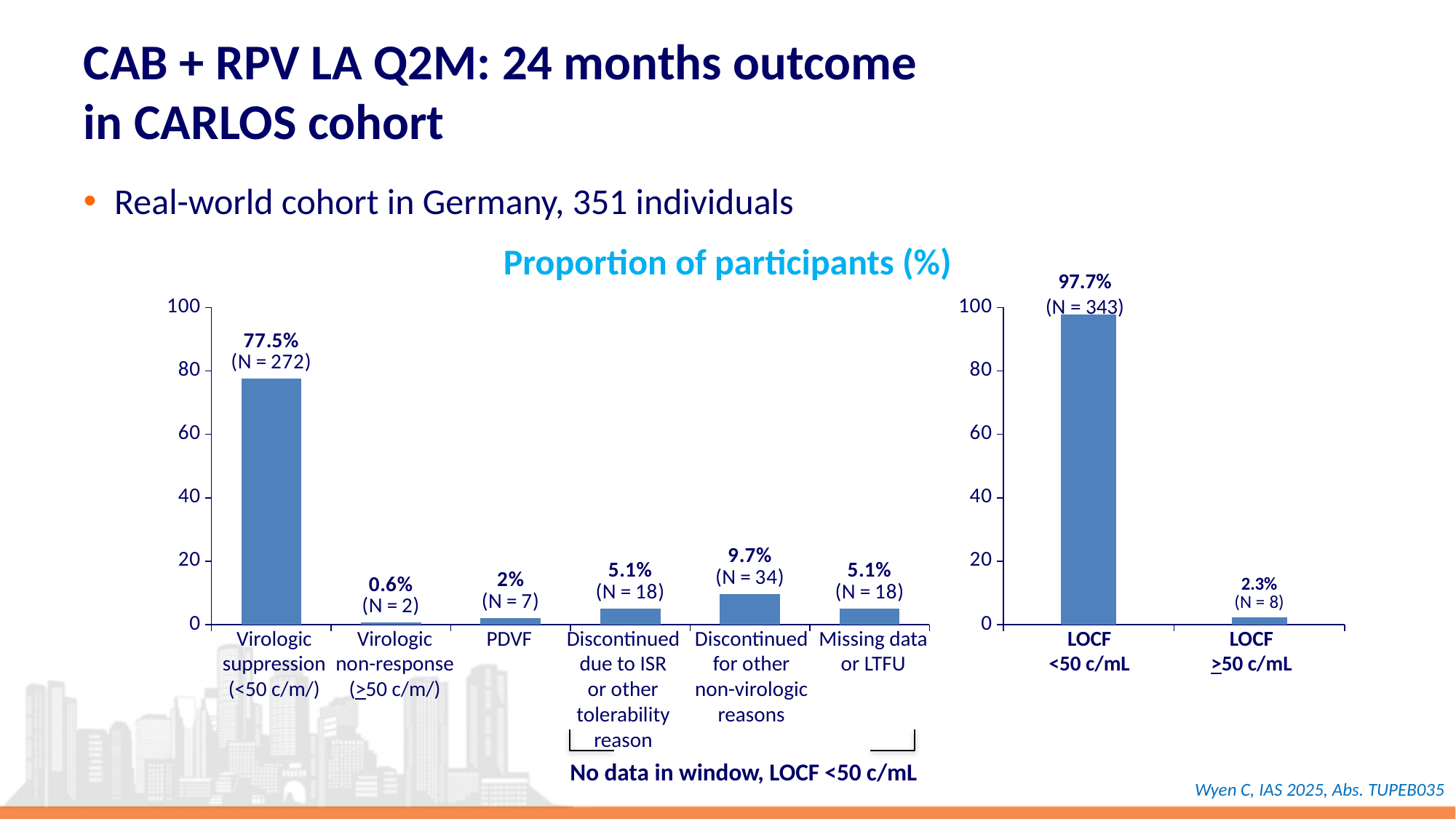
In the left chart, how many participants (N) are in the Discontinued for other non-virologic reasons category? N = 34 In the right chart, what is the N for LOCF >50 c/mL? N = 8 In the right chart, what is the value for LOCF <50 c/mL? 97.7% In the left chart, what is the difference between Discontinued for other non-virologic reasons and Discontinued due to ISR or other tolerability reason? 4.6% How many categories are shown in the left chart? 6 In the left chart, what is the value for Virologic suppression (<50 c/m/)? 77.5% In the left chart, which is larger: PDVF or Missing data or LTFU? Missing data or LTFU In the right chart, what is the difference between LOCF <50 c/mL and LOCF >50 c/mL? 95.4% In the left chart, which category has the highest value? Virologic suppression (<50 c/m/) What type of chart is used on this slide? Bar chart In the left chart, which category has the lowest value? Virologic non-response (>50 c/m/) In the left chart, what is the value for PDVF? 2%